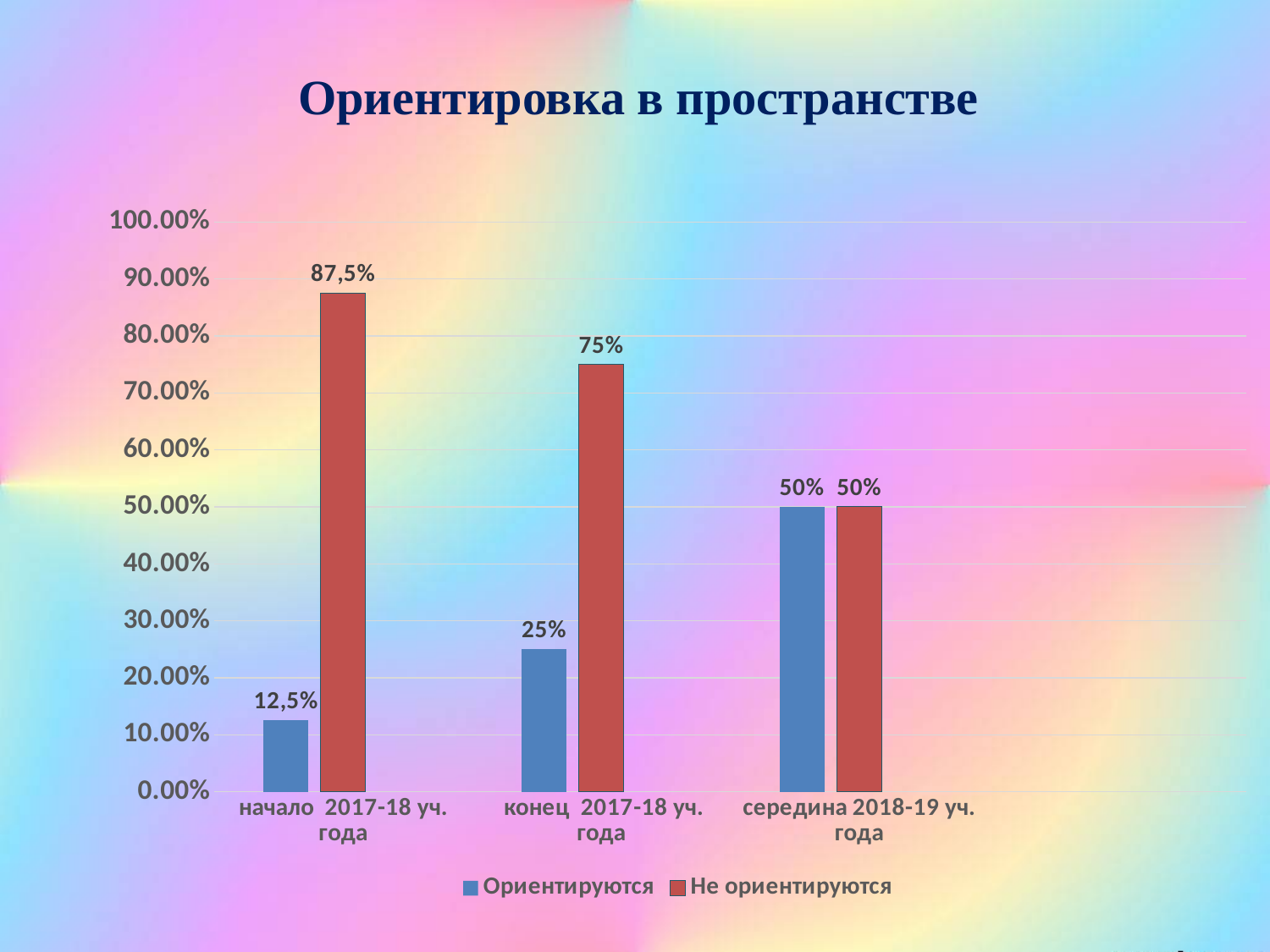
What is the value for "Ориентируются" at "начало 2017-18 уч. года"? 12,5% How many series does the legend list? 2 How many categories are shown on the x axis? 3 Which is larger at "начало 2017-18 уч. года": "Ориентируются" or "Не ориентируются"? Не ориентируются What is the value for "Ориентируются" at "конец 2017-18 уч. года"? 25% What is the difference between "Не ориентируются" and "Ориентируются" at "конец 2017-18 уч. года"? 50% In which category is the "Ориентируются" series lowest? начало 2017-18 уч. года Does the "Ориентируются" series rise or fall across the categories from left to right? rise What kind of chart is shown on the slide? bar chart In which category is the "Не ориентируются" series highest? начало 2017-18 уч. года What is the value for "Не ориентируются" at "начало 2017-18 уч. года"? 87,5% What is the value for "Не ориентируются" at "середина 2018-19 уч. года"? 50%